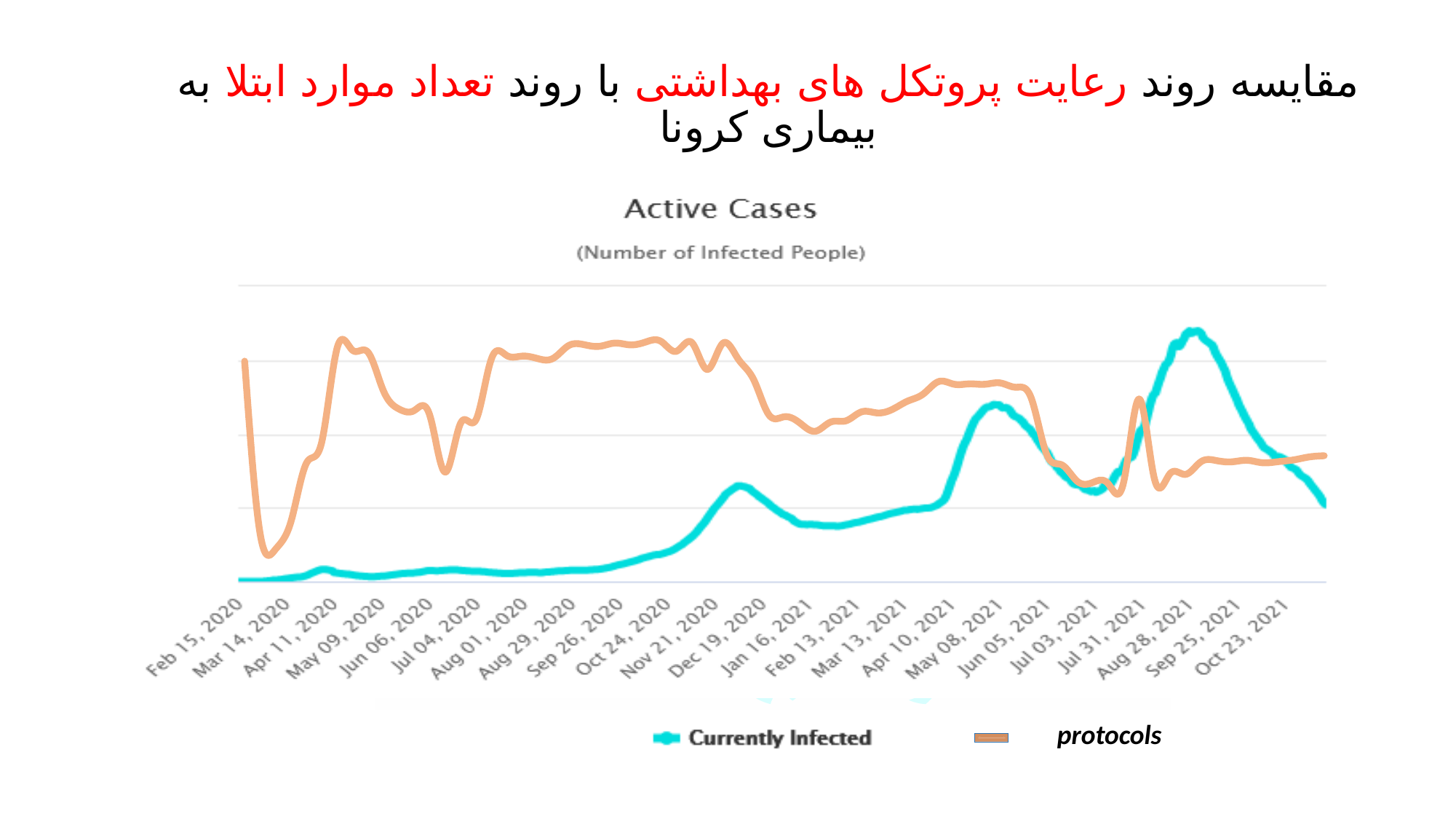
Does the Currently Infected line rise or fall between Jul 31, 2021 and Aug 28, 2021? Rise What is the first date label on the x axis of the chart? Feb 15, 2020 How many series does the legend of the chart list? 2 Does the protocols line rise or fall between Feb 15, 2020 and Mar 14, 2020? Fall Does the Currently Infected line rise or fall between Sep 25, 2021 and Oct 23, 2021? Fall What is the title of the chart? Active Cases What is the last date label on the x axis of the chart? Oct 23, 2021 What are the two series named in the chart legend? Currently Infected and protocols What kind of chart is shown on the slide? Line chart At Aug 28, 2021, which series is higher: Currently Infected or protocols? Currently Infected At Jun 06, 2020, which series is higher: Currently Infected or protocols? protocols How many date labels are shown on the x axis of the chart? 23